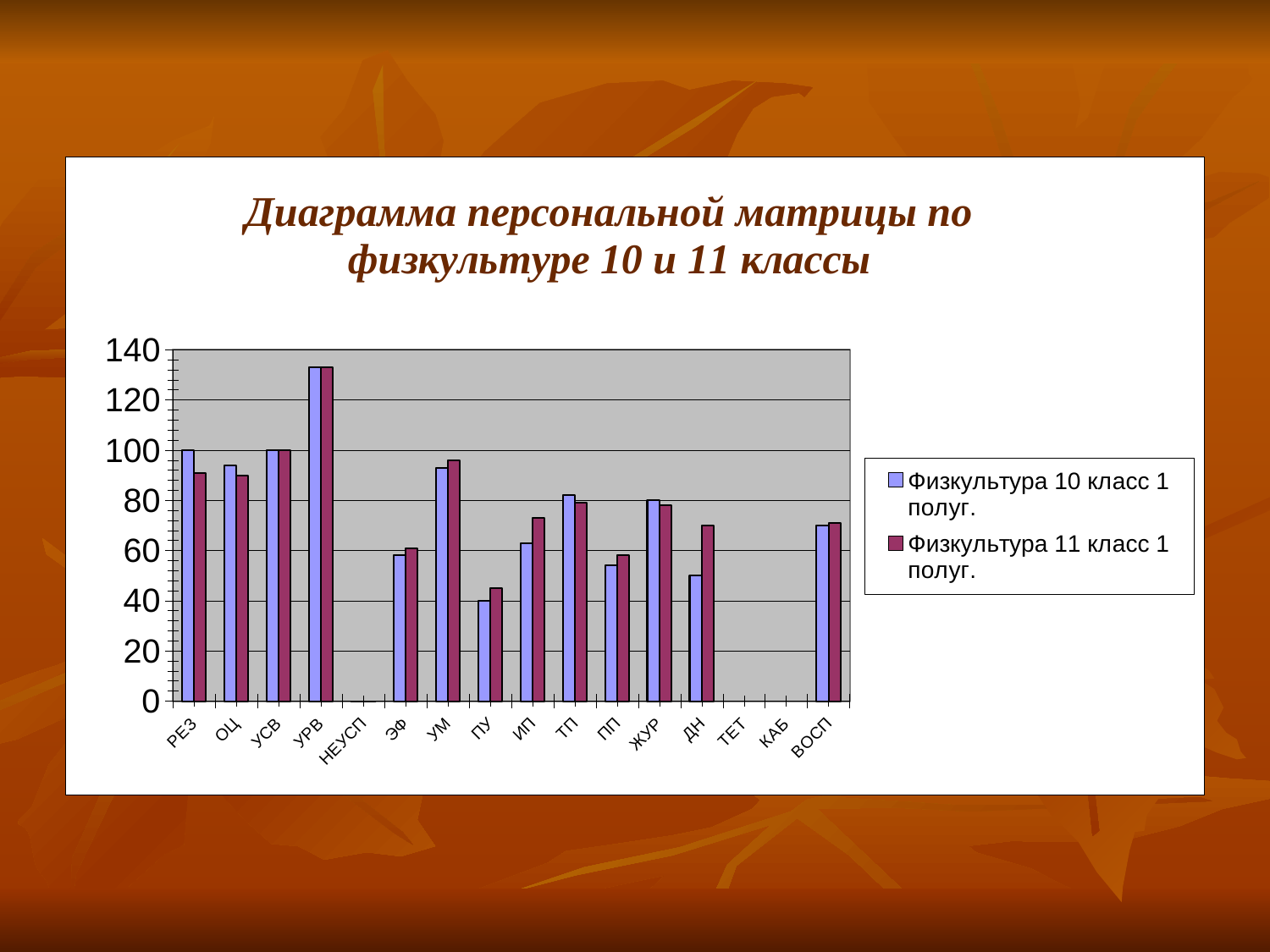
For ДН, which series has the larger value: Физкультура 10 класс 1 полуг. or Физкультура 11 класс 1 полуг.? Физкультура 11 класс 1 полуг. Is the value for ПУ in the Физкультура 10 класс 1 полуг. series greater or less than 60? less For ИП, which series has the larger value: Физкультура 10 класс 1 полуг. or Физкультура 11 класс 1 полуг.? Физкультура 11 класс 1 полуг. Is the value for ДН in the Физкультура 11 класс 1 полуг. series greater or less than 60? greater Is the value for ДН in the Физкультура 10 класс 1 полуг. series greater or less than 60? less How many series does the legend list? 2 What is the title of the chart? Диаграмма персональной матрицы по физкультуре 10 и 11 классы What kind of chart is shown on the slide? bar chart How many categories are shown on the x axis? 16 Which category has the highest value for Физкультура 10 класс 1 полуг.? УРВ Which category has the highest value for Физкультура 11 класс 1 полуг.? УРВ